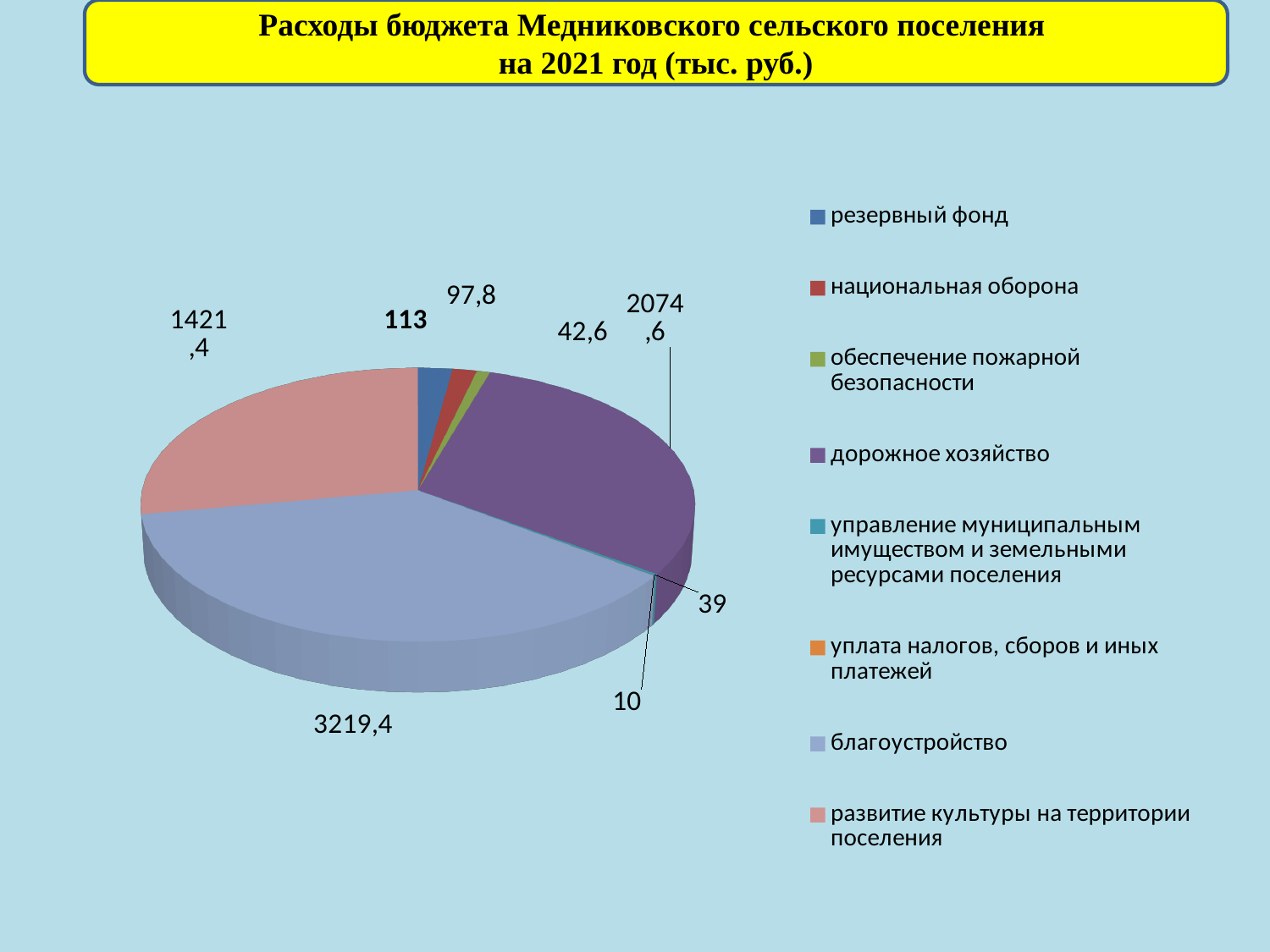
Which category has the smallest slice of the pie? уплата налогов, сборов и иных платежей How many categories does the legend of the pie chart list? 8 What kind of chart is shown on the slide? pie chart What is the title of the chart on the slide? Расходы бюджета Медниковского сельского поселения на 2021 год (тыс. руб.) Which category has the largest slice of the pie? благоустройство What is the difference between the values for благоустройство and дорожное хозяйство? 1144,8 Which is larger, the value for национальная оборона or the value for обеспечение пожарной безопасности? национальная оборона What is the value for уплата налогов, сборов и иных платежей? 10 What is the value for резервный фонд? 113 What is the value for дорожное хозяйство? 2074,6 What is the value for благоустройство? 3219,4 What is the value for развитие культуры на территории поселения? 1421,4